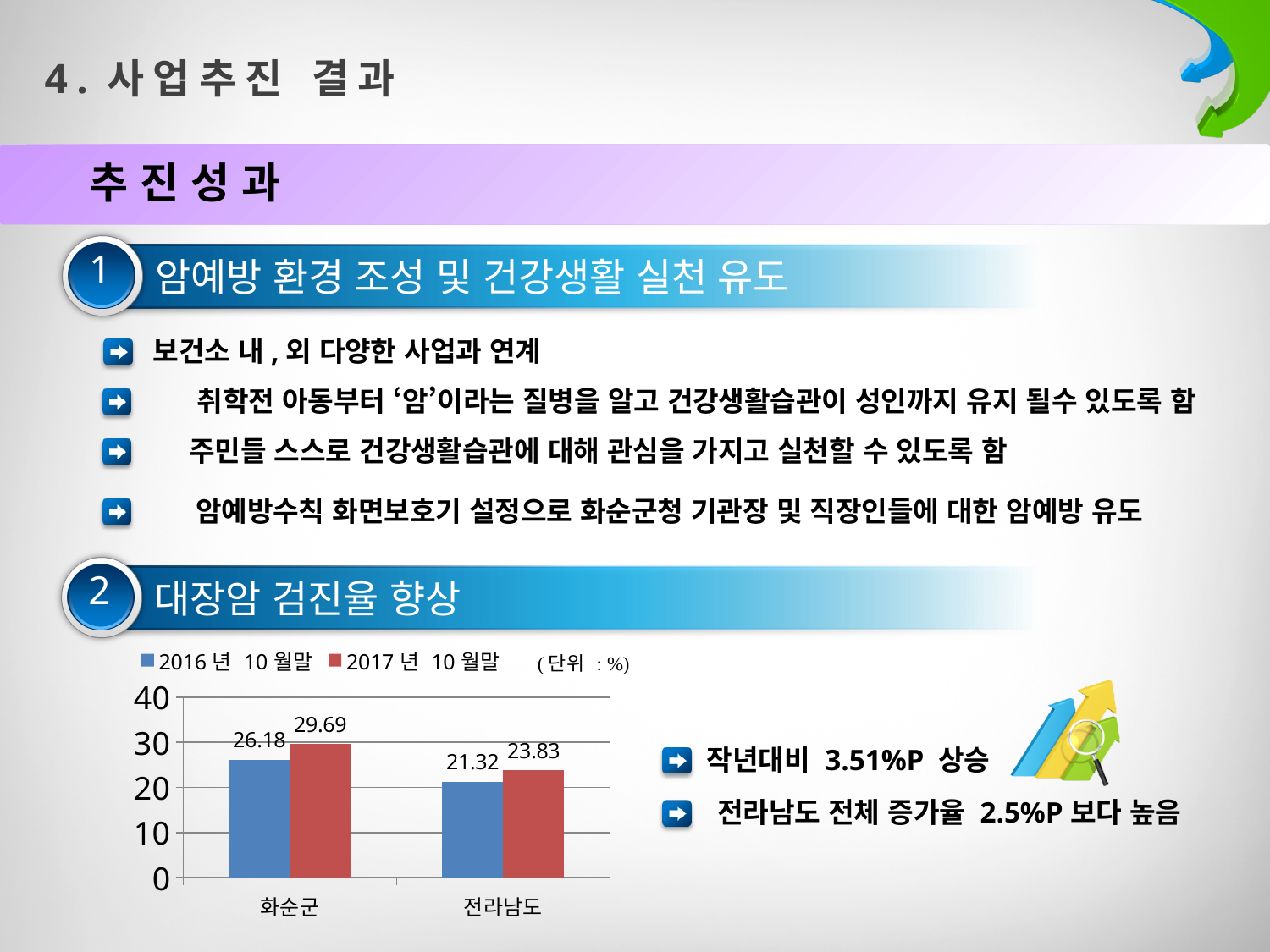
What is the value for 전라남도 in the 2017년 10월말 series? 23.83 What is the value for 화순군 in the 2016년 10월말 series? 26.18 Which is larger: the 2016년 10월말 value for 화순군 or the 2017년 10월말 value for 전라남도? 2016년 10월말 value for 화순군 What is the difference between the 2017년 10월말 and 2016년 10월말 values for 전라남도? 2.51 How many series does the chart legend list? 2 Which category has the highest value in the 2017년 10월말 series? 화순군 What type of chart is shown on the slide? bar chart What is the value for 전라남도 in the 2016년 10월말 series? 21.32 What is the difference between the 2017년 10월말 and 2016년 10월말 values for 화순군? 3.51 What is the value for 화순군 in the 2017년 10월말 series? 29.69 How many categories are shown on the x axis of the chart? 2 Which category has the lowest value in the 2016년 10월말 series? 전라남도